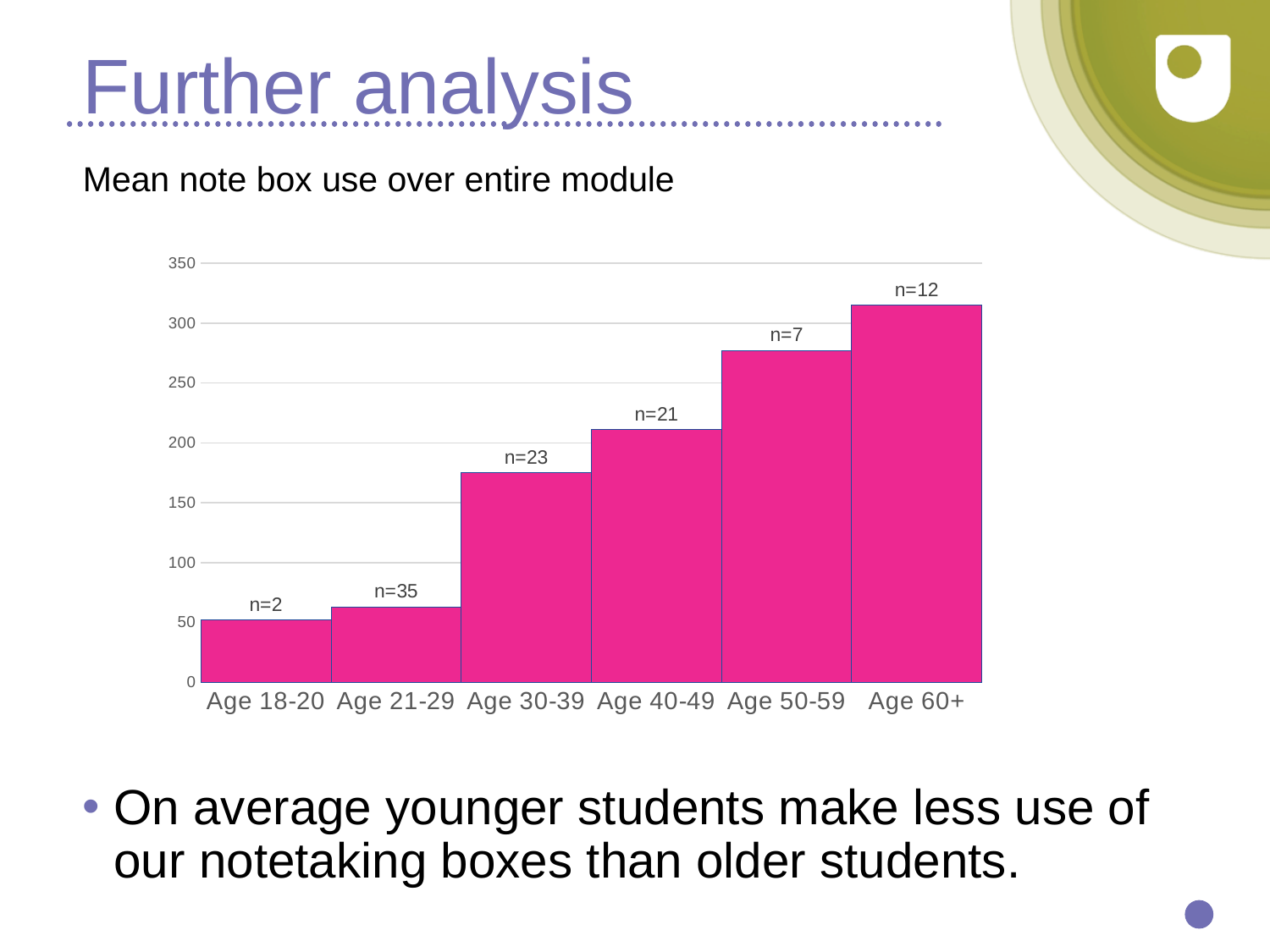
Is the value for Age 21-29 greater or less than 100? less Is the value for Age 50-59 greater or less than 300? less Is the value for Age 30-39 greater or less than 150? greater How many age categories are shown on the x axis of the chart? 6 What is the text shown above the chart describing what it plots? Mean note box use over entire module What kind of chart is shown on the slide? bar chart Do the values rise or fall as you move from Age 18-20 to Age 60+ along the x axis? rise Which age category has the highest mean note box use? Age 60+ What n label is printed above the bar for Age 21-29? n=35 Which age category has the lowest mean note box use? Age 18-20 Which is larger, the value for Age 50-59 or the value for Age 30-39? Age 50-59